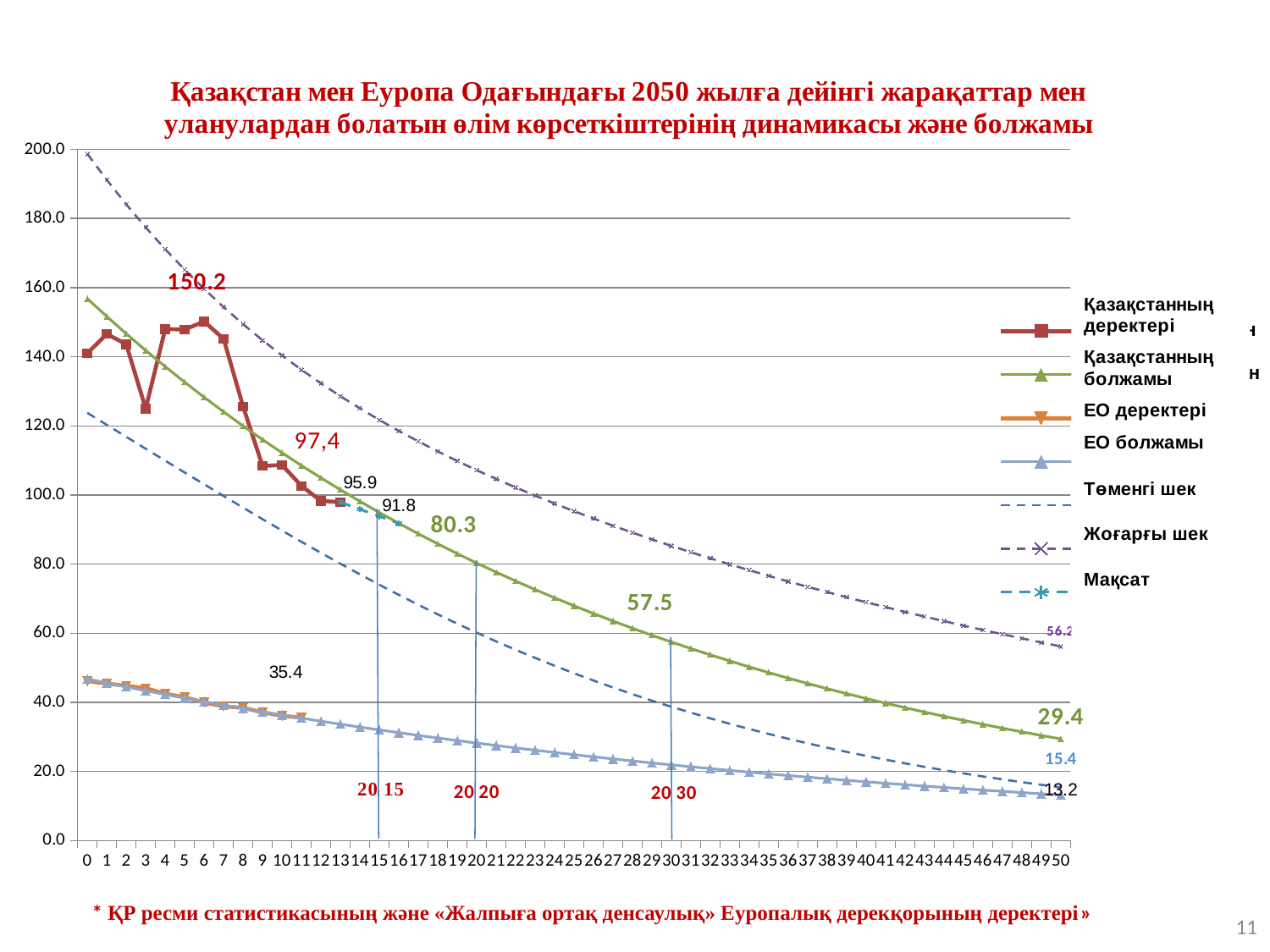
What is the highest labelled value of the Қазақстанның деректері series? 150.2 What is the difference between the Қазақстанның болжамы values at the 2020 marker (80.3) and the 2030 marker (57.5)? 22.8 At the right end of the chart, which is larger: the Қазақстанның болжамы value or the ЕО болжамы value? Қазақстанның болжамы What is the value of the Қазақстанның болжамы series at the 2020 marker? 80.3 What is the final labelled value of the Қазақстанның болжамы series at the right end of the chart? 29.4 What is the final labelled value of the ЕО болжамы series at the right end of the chart? 15.4 Is the value of the Жоғарғы шек series at x = 0 greater or less than 180? greater What is the value of the Қазақстанның болжамы series at the 2030 marker? 57.5 What kind of chart is shown on the slide? line chart What is the final labelled value of the Жоғарғы шек series at the right end of the chart? 56.2 Does the Қазақстанның болжамы series rise or fall along the x axis? fall How many series does the legend list? 7